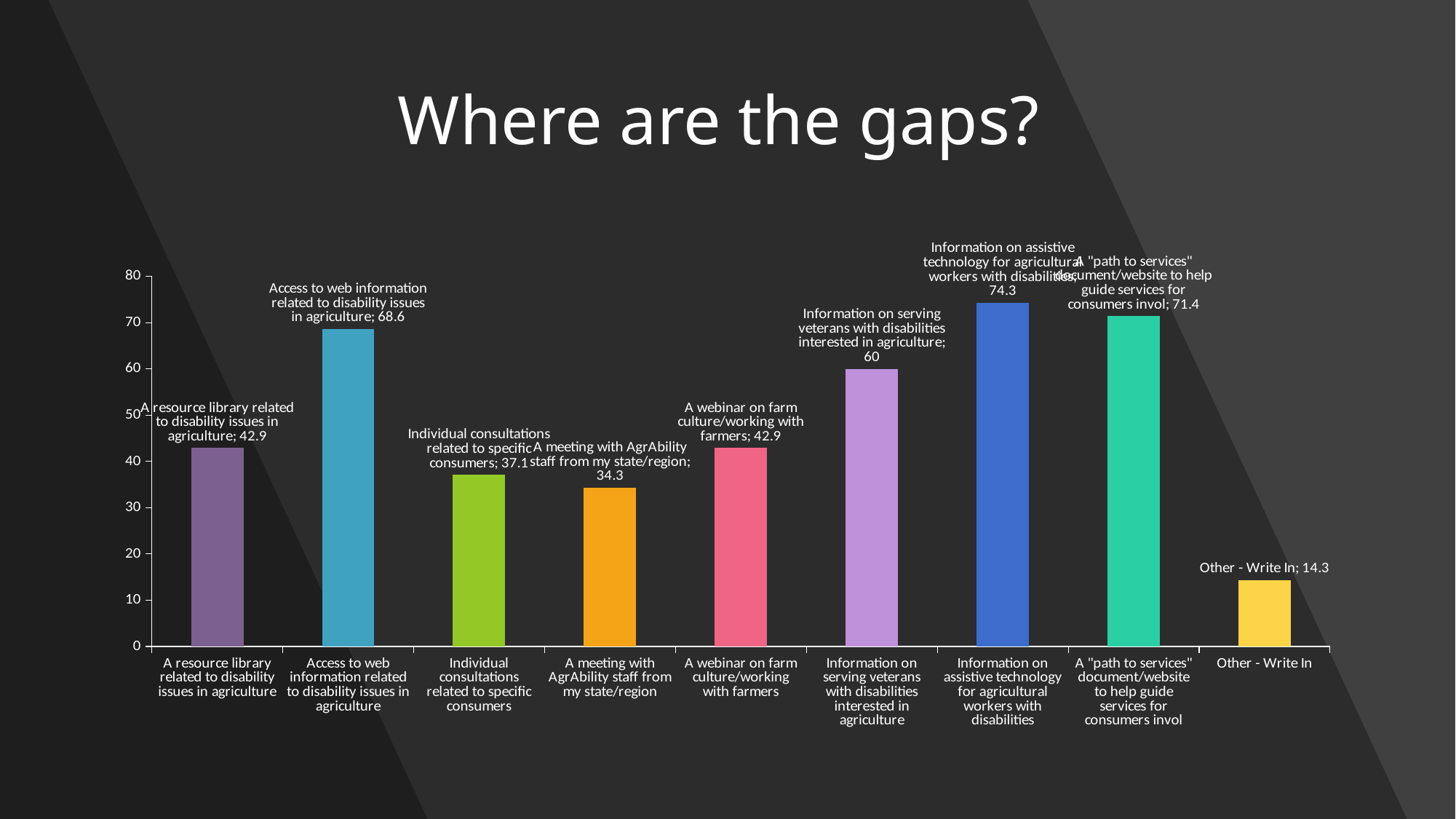
What is the title of the slide? Where are the gaps? Which category has the lowest value? Other - Write In Which category has the highest value? Information on assistive technology for agricultural workers with disabilities What is the value for "Access to web information related to disability issues in agriculture"? 68.6 What is the difference between the values for "Information on assistive technology for agricultural workers with disabilities" and "A "path to services" document/website to help guide services for consumers invol"? 2.9 What is the value for "A meeting with AgrAbility staff from my state/region"? 34.3 Is the value for "A webinar on farm culture/working with farmers" greater or less than 40? greater How many categories are shown in the chart? 9 What is the value for "Other - Write In"? 14.3 Which is larger: the value for "Individual consultations related to specific consumers" or the value for "A meeting with AgrAbility staff from my state/region"? Individual consultations related to specific consumers What kind of chart is shown on the slide? bar chart What is the value for "Information on serving veterans with disabilities interested in agriculture"? 60